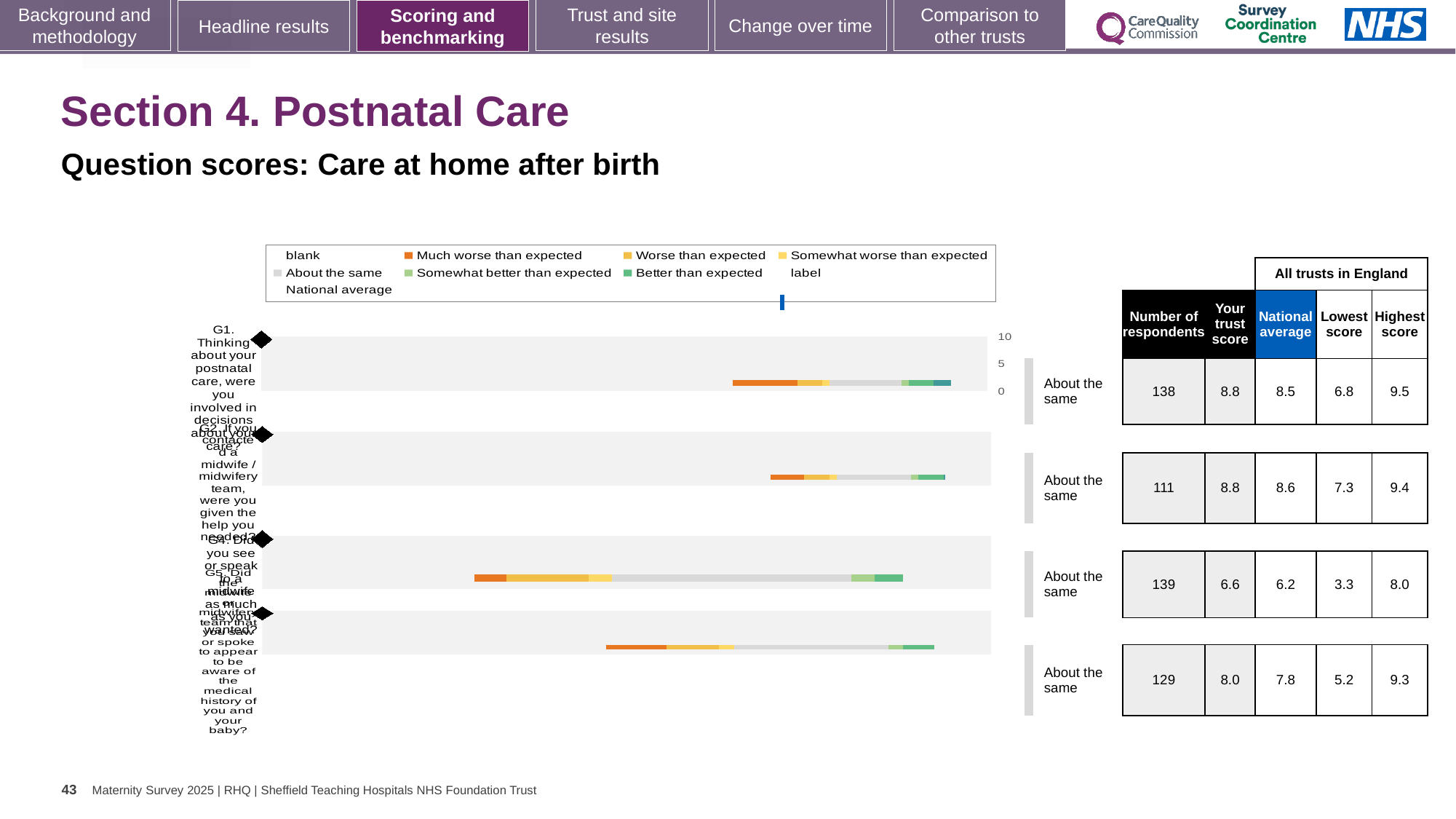
In the table beside the chart, what is the national average for the second question row? 8.6 In the table beside the chart, which question row has the highest number of respondents? the third row (139) Which legend entry is shown in orange in the chart's legend? Much worse than expected In the table beside the chart, what is the number of respondents for the first (top) question row? 138 What kind of chart is shown on the slide? bar chart How many question bars are plotted in the chart? 4 Which legend entry is shown in light grey in the chart's legend? About the same In the table beside the chart, what is the difference between 'Your trust score' and the national average for the third question row? 0.4 In the table beside the chart, which question row has the lowest 'Your trust score'? the third row (6.6) In the table beside the chart, what is the highest score for the fourth (bottom) question row? 9.3 In the table beside the chart, for the first question row, which is larger: 'Your trust score' or the national average? Your trust score In the table beside the chart, what is the lowest score for the third question row? 3.3